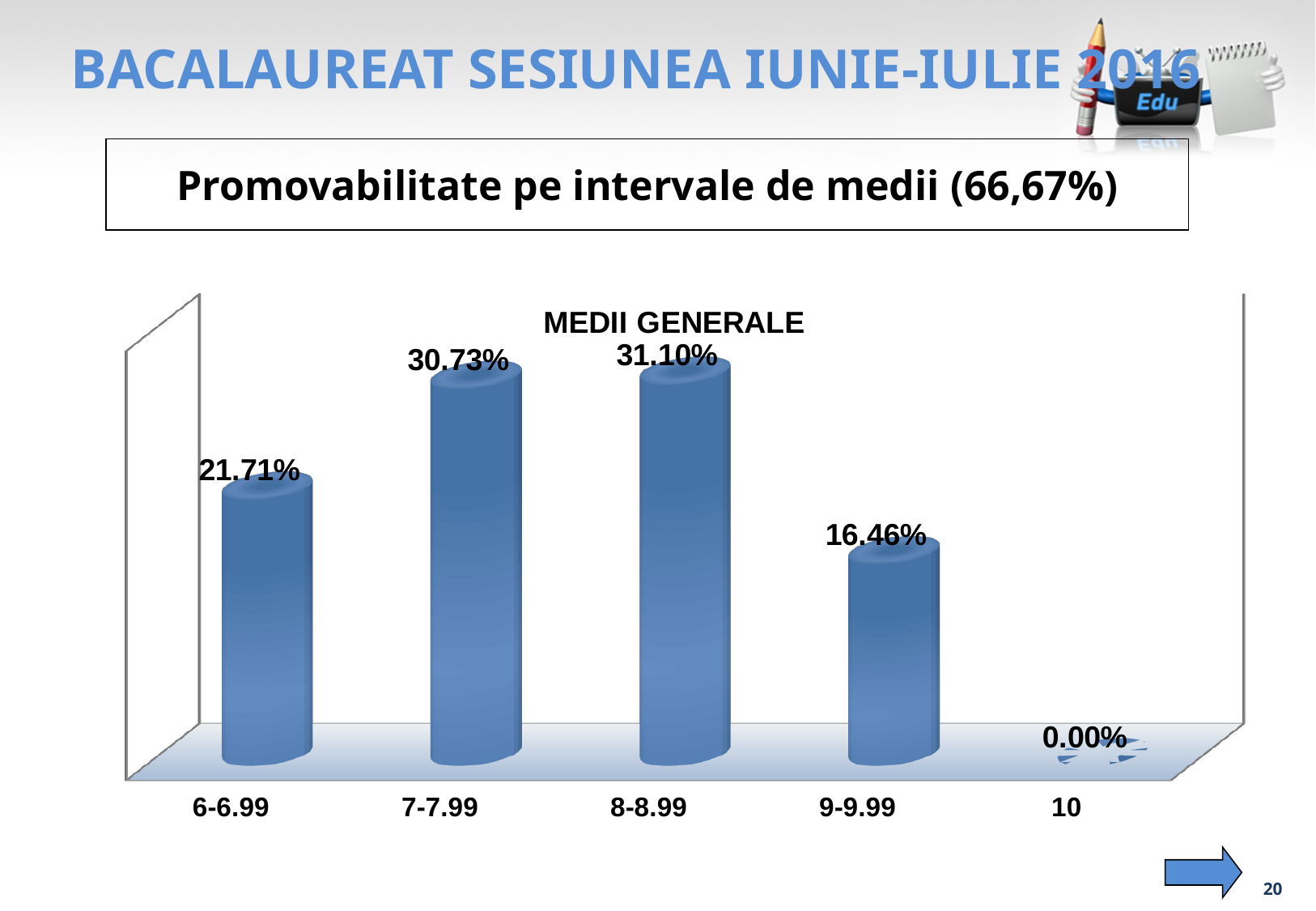
What is the value for the 10 category? 0.00% Which category has the lowest value? 10 What is the difference between the values for 6-6.99 and 9-9.99? 5.25% What is the difference between the values for 8-8.99 and 7-7.99? 0.37% What is the value for the 9-9.99 interval? 16.46% How many categories are shown on the x axis? 5 What is the value for the 8-8.99 interval? 31.10% Which interval has the highest value? 8-8.99 What type of chart is shown? bar chart Which is larger, the value for 6-6.99 or the value for 9-9.99? 6-6.99 What is the value for the 7-7.99 interval? 30.73% What is the value for the 6-6.99 interval? 21.71%